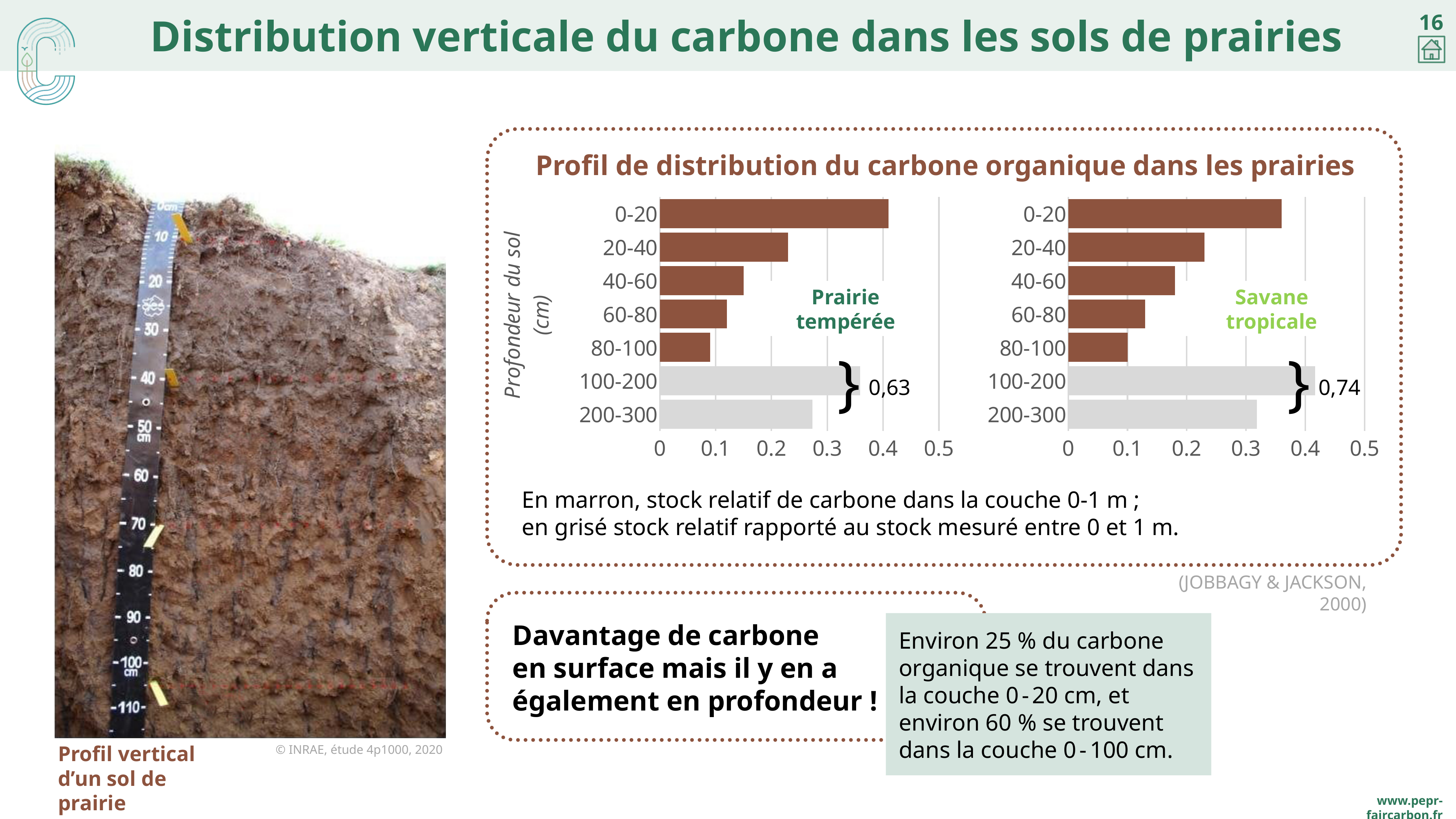
On the "Prairie tempérée" chart, which depth layer has the longest bar? 0-20 What value is printed next to the brace grouping the grey bars on the "Prairie tempérée" chart? 0,63 On the "Savane tropicale" chart, which depth layer has the shortest bar? 80-100 Which chart shows a larger value for the 100-200 layer, "Prairie tempérée" or "Savane tropicale"? Savane tropicale On the "Prairie tempérée" chart, is the value for 200-300 greater or less than 0.3? less What is the label of the vertical axis shared by the two charts? Profondeur du sol (cm) On the "Savane tropicale" chart, is the value for 60-80 greater or less than 0.2? less Which chart shows a larger value for the 0-20 layer, "Prairie tempérée" or "Savane tropicale"? Prairie tempérée On the "Savane tropicale" chart, do the brown bars increase or decrease from the 0-20 layer down to the 80-100 layer? decrease What kind of chart is the "Prairie tempérée" chart? bar chart On the "Prairie tempérée" chart, is the value for 0-20 greater or less than 0.3? greater How many depth categories are shown on the "Savane tropicale" chart? 7